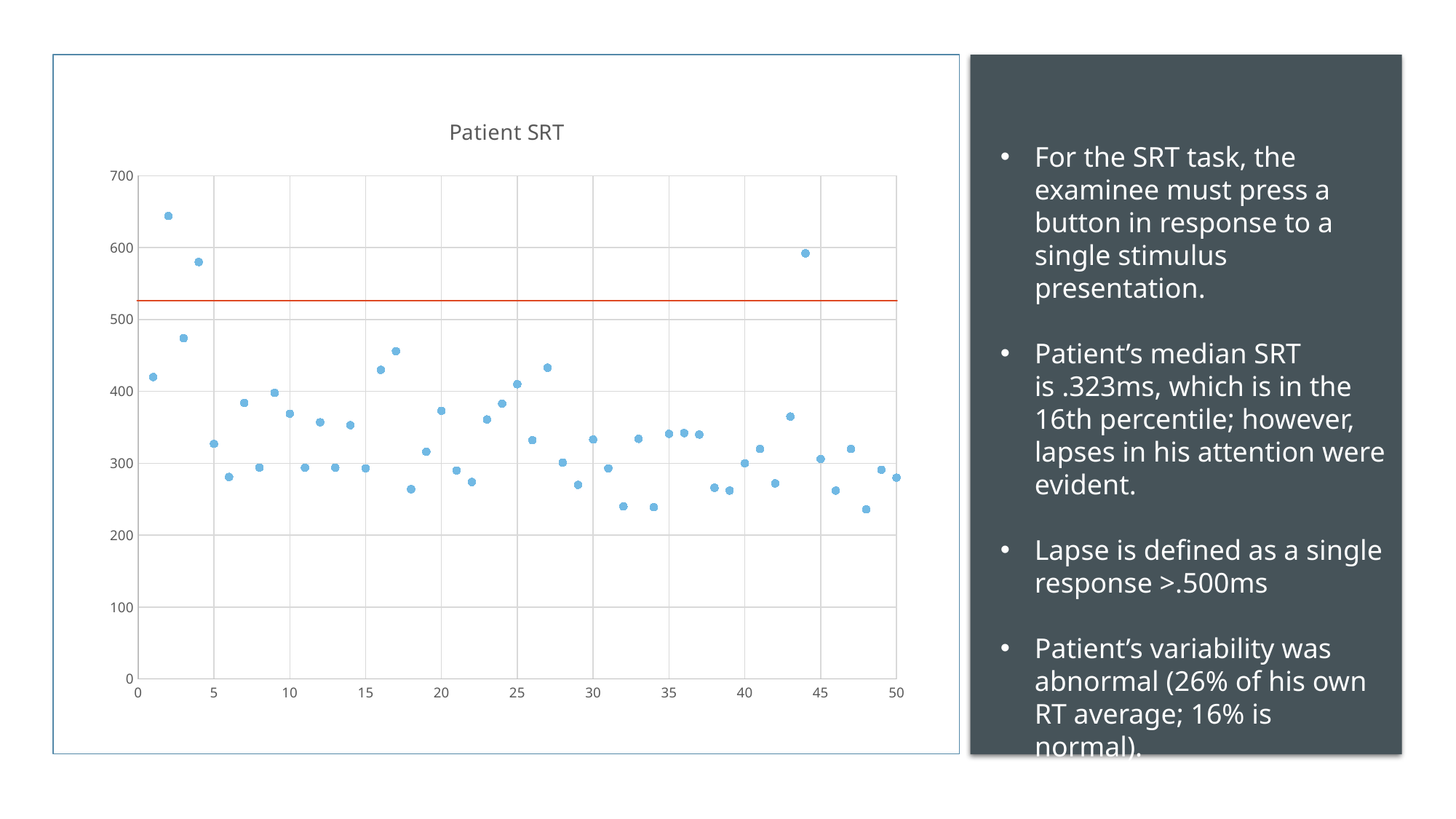
Is the value at x = 1 greater or less than 400? greater Is the value at x = 2 greater or less than 600? greater How many points lie above the red horizontal line in the chart? 3 Is the value at x = 44 greater or less than 500? greater What is the highest value shown on the y axis of the chart? 700 What kind of chart is shown on the slide? Scatter chart What is the title of the chart? Patient SRT Which has the larger value, the point at x = 2 or the point at x = 4? x = 2 Which has the larger value, the point at x = 44 or the point at x = 3? x = 44 How many data points are plotted in the Patient SRT chart? 50 At which x value does the highest point in the Patient SRT chart occur? 2